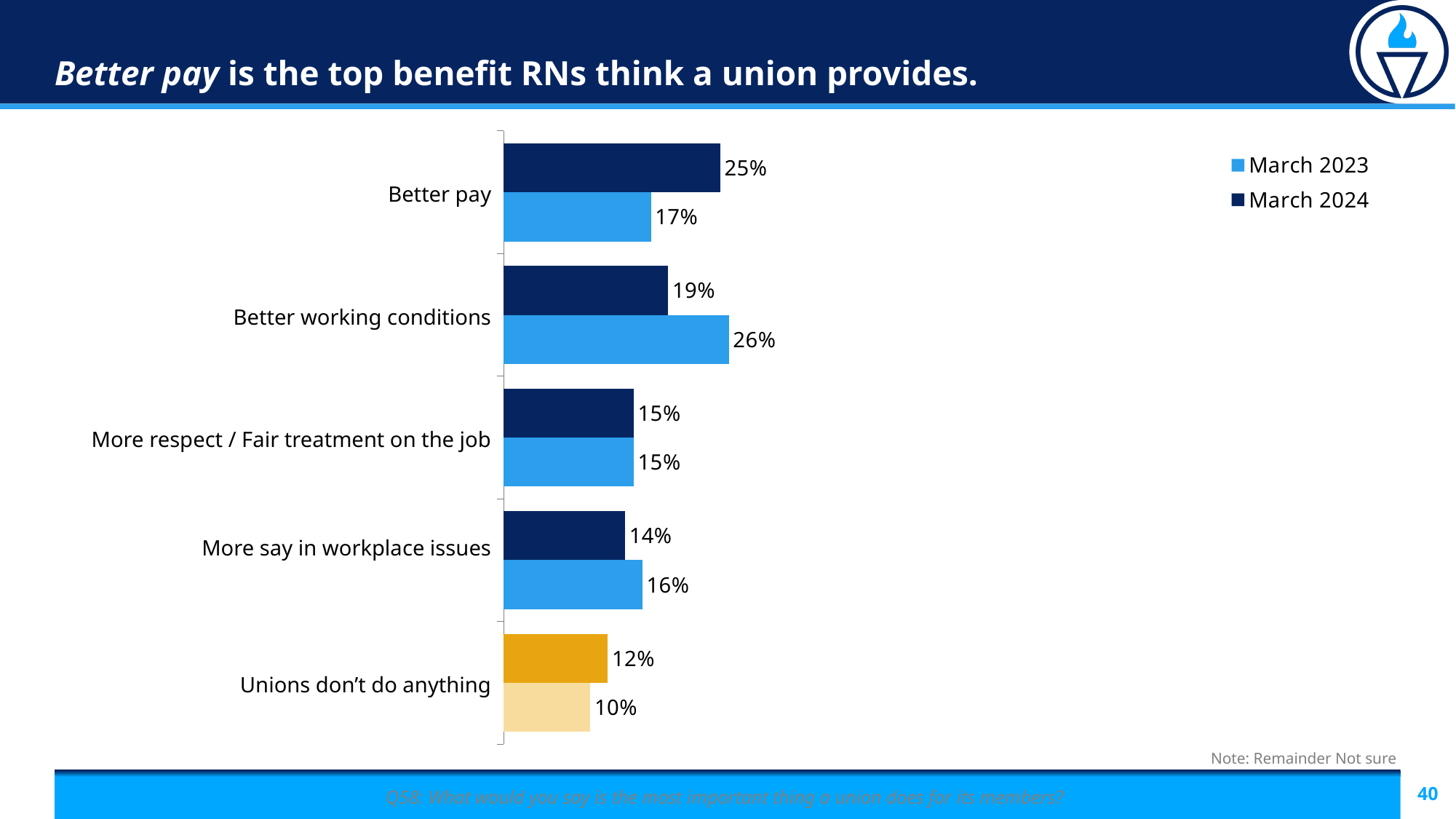
What is the March 2024 value for Better pay? 25% How many categories are shown on the chart? 5 What is the March 2023 value for More say in workplace issues? 16% Which is larger for Better working conditions: the March 2023 value or the March 2024 value? March 2023 What is the March 2024 value for More respect / Fair treatment on the job? 15% How many series does the legend list? 2 What is the difference between the March 2024 and March 2023 values for Better pay? 8 percentage points Which series is shown in dark blue in the legend? March 2024 Which category has the highest March 2024 value? Better pay Which category has the lowest March 2023 value? Unions don't do anything What is the March 2023 value for Better working conditions? 26% What kind of chart is shown on the slide? Bar chart